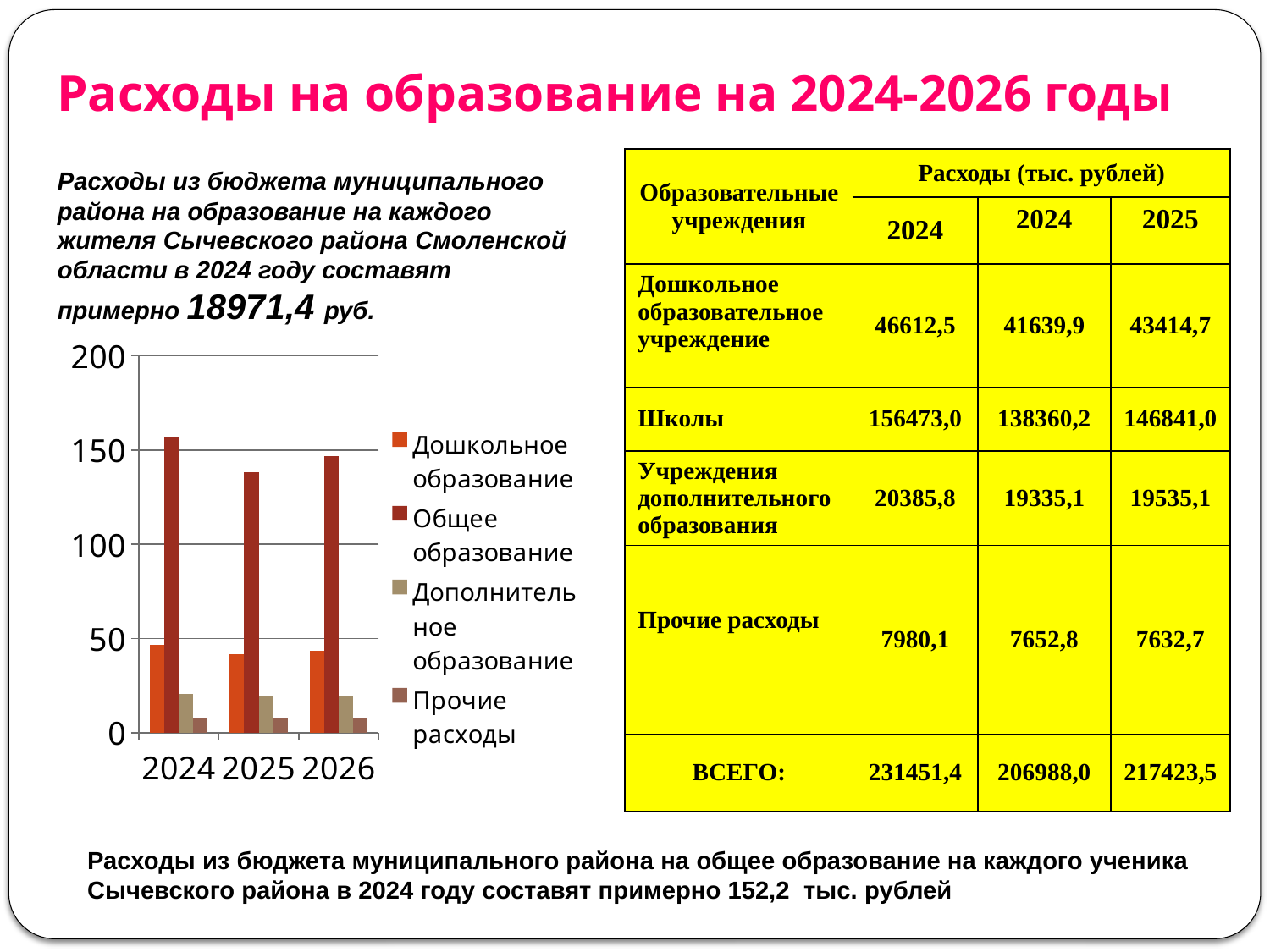
What kind of chart is shown on the slide? bar chart Is the value for Дошкольное образование in 2025 greater or less than 50? less Which is larger: Общее образование in 2024 or Общее образование in 2025? 2024 Which series has the lowest bar in 2026? Прочие расходы From 2024 to 2025, does the value for Общее образование rise or fall? fall How many series does the chart legend list? 4 Which series has the highest bar in 2024? Общее образование How many year categories are shown on the x axis of the chart? 3 Is the value for Общее образование in 2025 greater or less than 150? less Is the value for Дополнительное образование in 2024 greater or less than 50? less Which legend entry is shown in the orange colour? Дошкольное образование